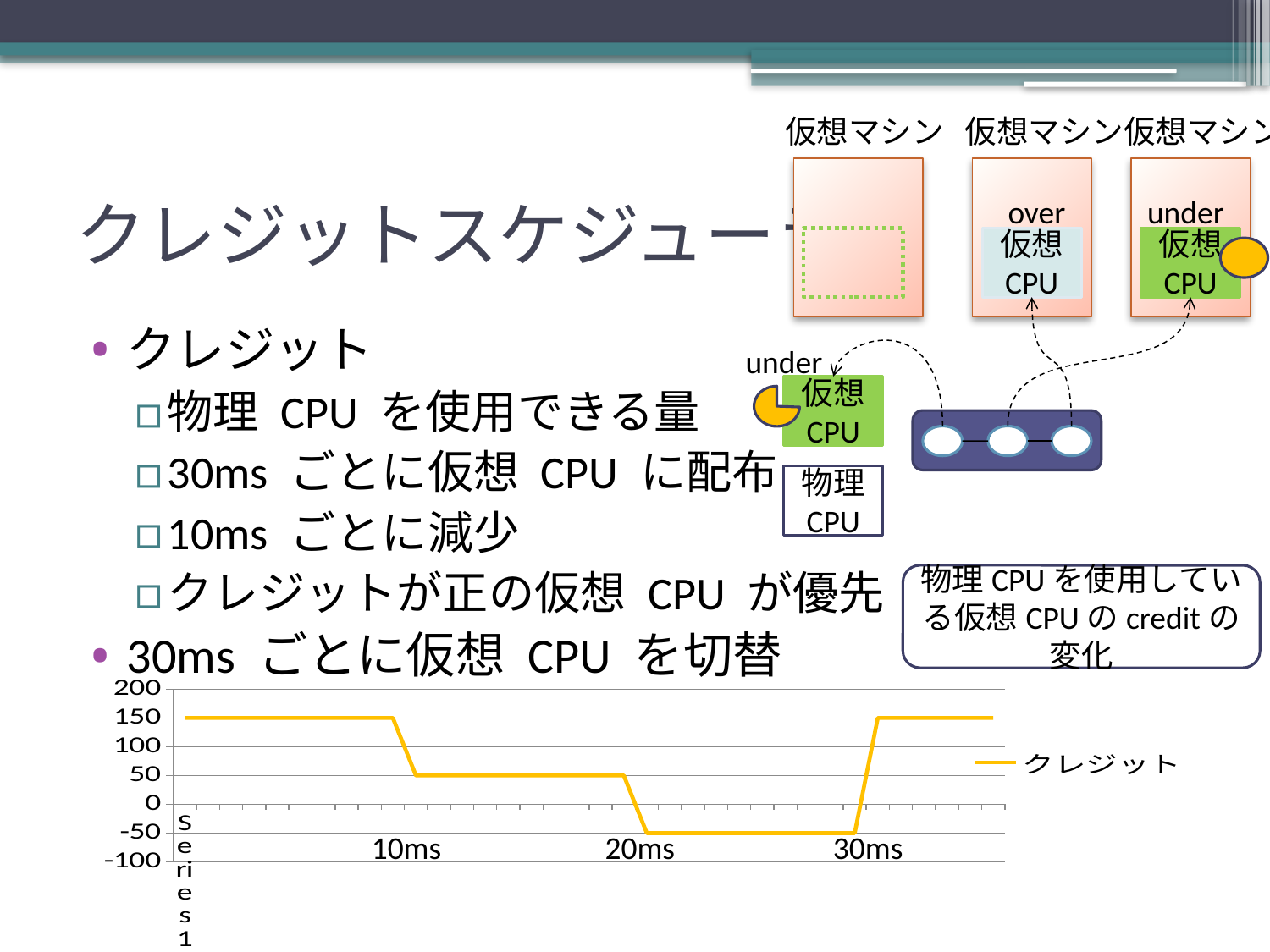
How many time labels are shown on the chart's x axis? 3 What kind of chart is shown at the bottom of the slide? line chart What is the credit value between 20ms and 30ms? -50 Which is larger: the credit value before 10ms or the credit value between 10ms and 20ms? before 10ms What is the name of the series shown in the chart's legend? クレジット Does the credit value rise or fall from the start of the chart to 20ms? fall How many series does the chart's legend list? 1 What is the credit value between 10ms and 20ms? 50 What is the difference between the credit value before 10ms and the credit value between 10ms and 20ms? 100 What is the credit value after 30ms? 150 Is the credit value between 20ms and 30ms greater or less than 0? less What is the credit value at the start of the chart, before 10ms? 150